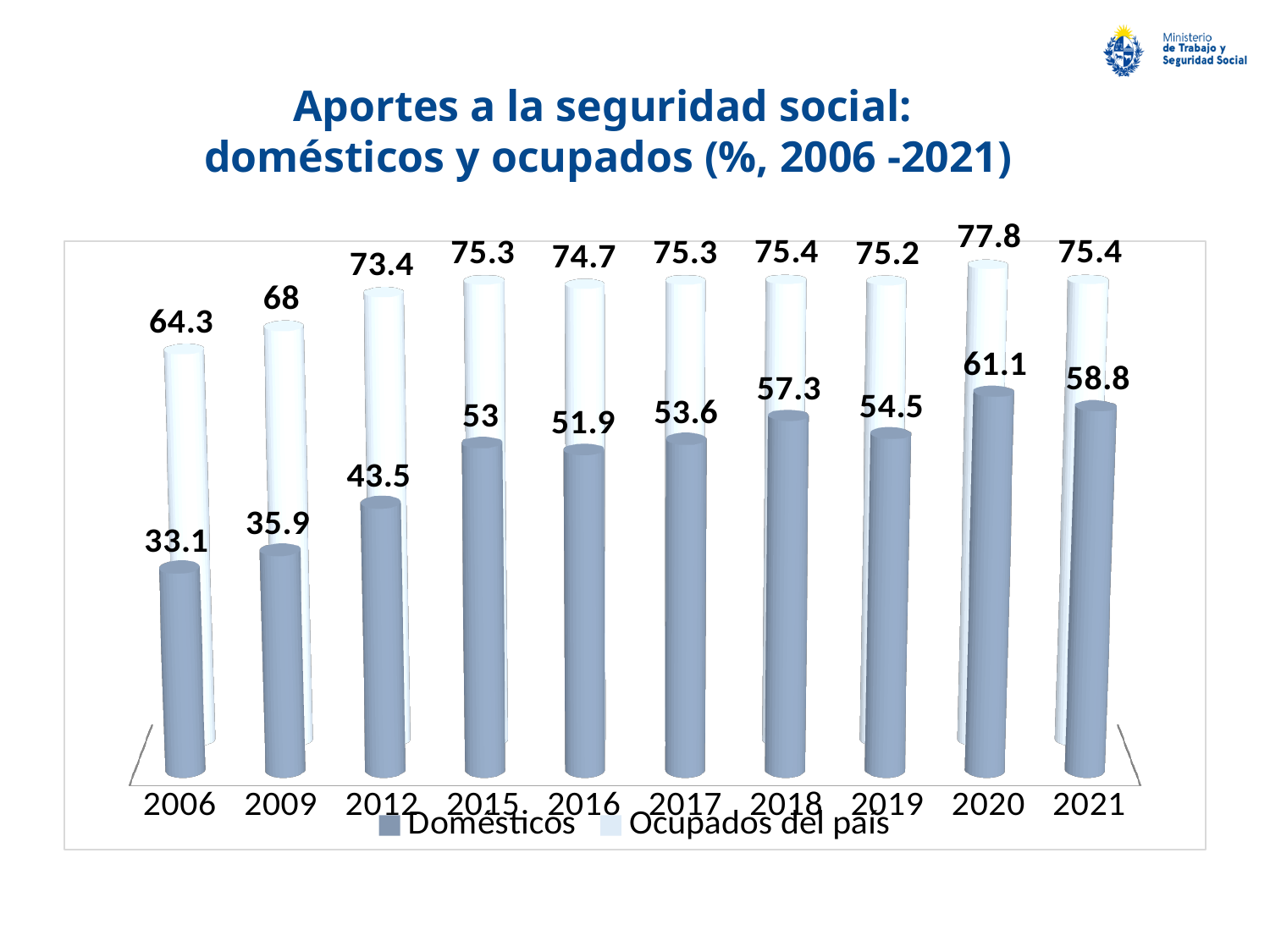
What is the difference between Ocupados del país and Domésticos in 2021? 16.6 What are the two series named in the legend? Domésticos and Ocupados del país Do the Domésticos values rise or fall from 2006 to 2012? rise How many series does the legend list? 2 What is the value for Domésticos in 2012? 43.5 What kind of chart is shown on the slide? bar chart In which year is the Domésticos value highest? 2020 By how much did the Domésticos value increase from 2006 to 2021? 25.7 How many years are shown on the x axis? 10 In which year is the Ocupados del país value lowest? 2006 Which year has the larger Domésticos value, 2015 or 2016? 2015 What is the value for Ocupados del país in 2020? 77.8